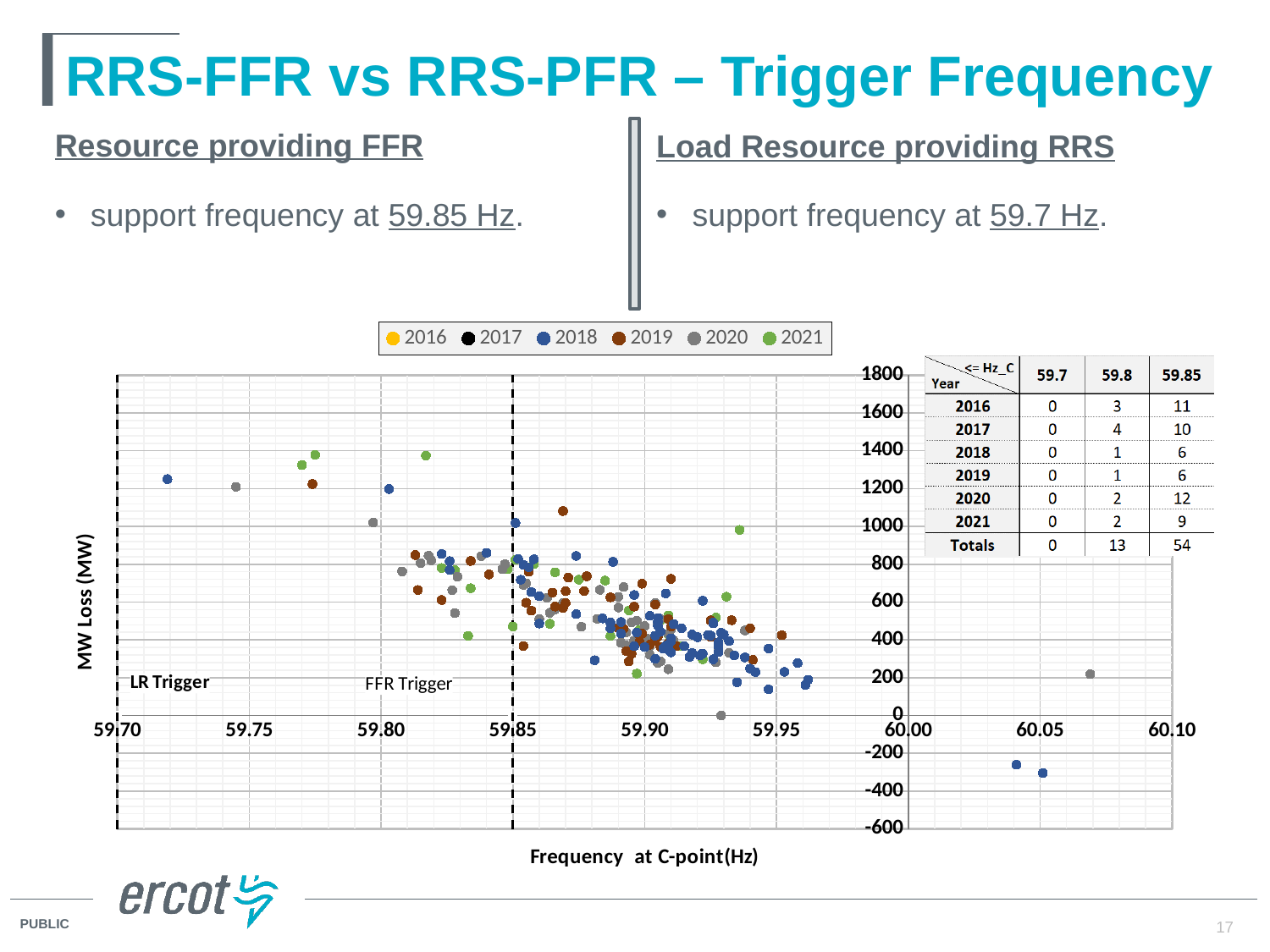
What are the series names listed in the chart legend? 2016, 2017, 2018, 2019, 2020, 2021 Is the MW Loss of the 2020 point plotted near 60.07 Hz greater or less than 400? less At what frequency is the dashed vertical line labeled "FFR Trigger" drawn? 59.85 As frequency at C-point increases along the x axis, does MW Loss generally rise or fall? fall In the table inset on the chart, how many events are listed for 2020 in the 59.85 column? 12 Is the MW Loss of the 2021 point plotted near 59.93 Hz greater or less than 800? greater What is the title of the chart's vertical axis? MW Loss (MW) In the table inset on the chart, what is the total for the 59.85 column? 54 Are the MW Loss values of the 2021 points plotted near 59.77–59.78 Hz greater or less than 1200? greater How many series does the chart legend list? 6 What kind of chart is shown on the slide? scatter chart